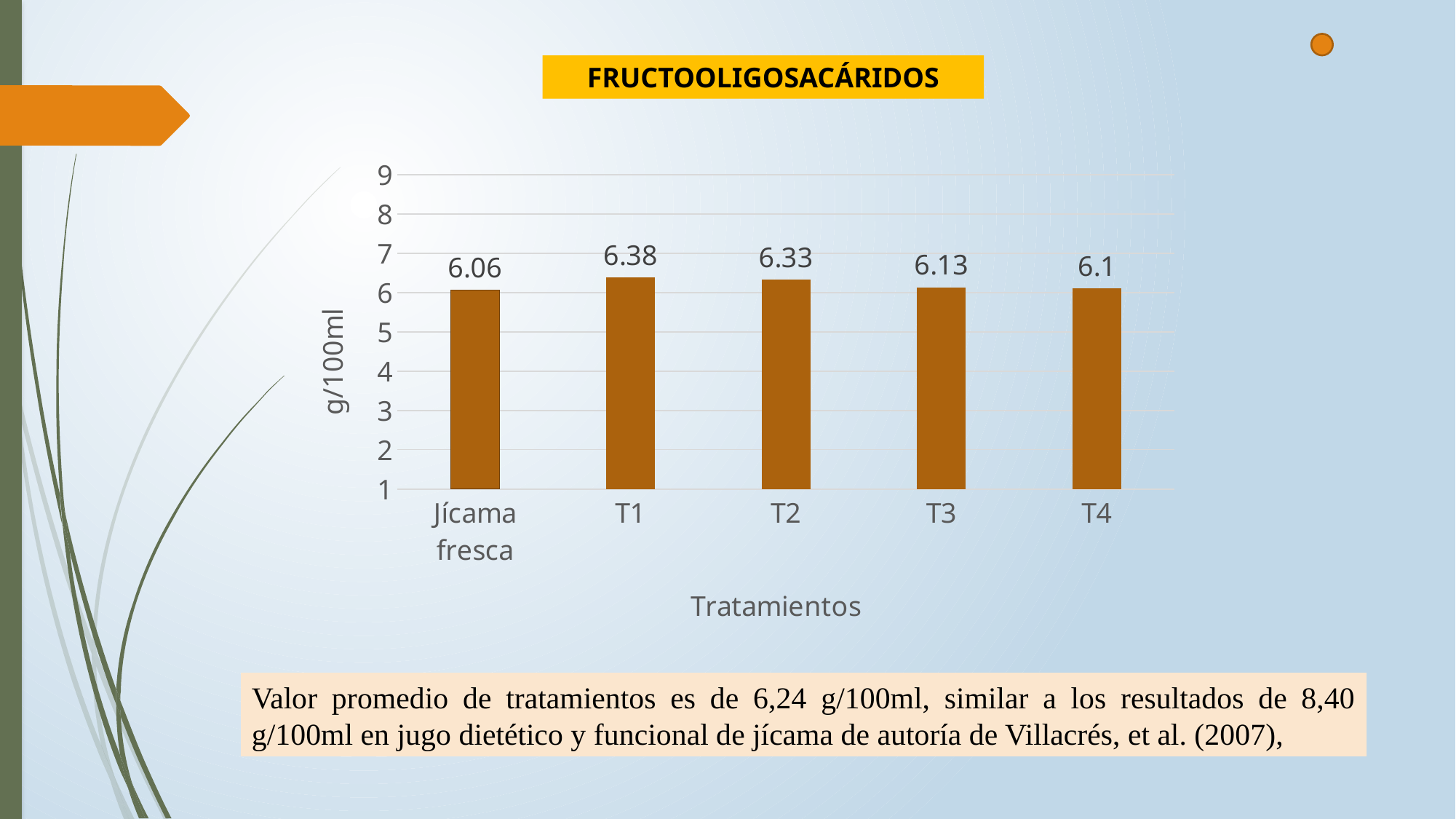
Which treatment has the highest value? T1 How many categories are shown on the x axis? 5 What is the difference between the values for T1 and T3? 0.25 Is the value for T3 greater or less than 7? less What is the difference between the values for T2 and Jícama fresca? 0.27 Which is larger, the value for T2 or the value for T4? T2 Which category has the lowest value? Jícama fresca What is the value for T4? 6.1 What is the value for Jícama fresca? 6.06 What is the value for T1? 6.38 What is the label of the y axis? g/100ml What kind of chart is shown on the slide? bar chart